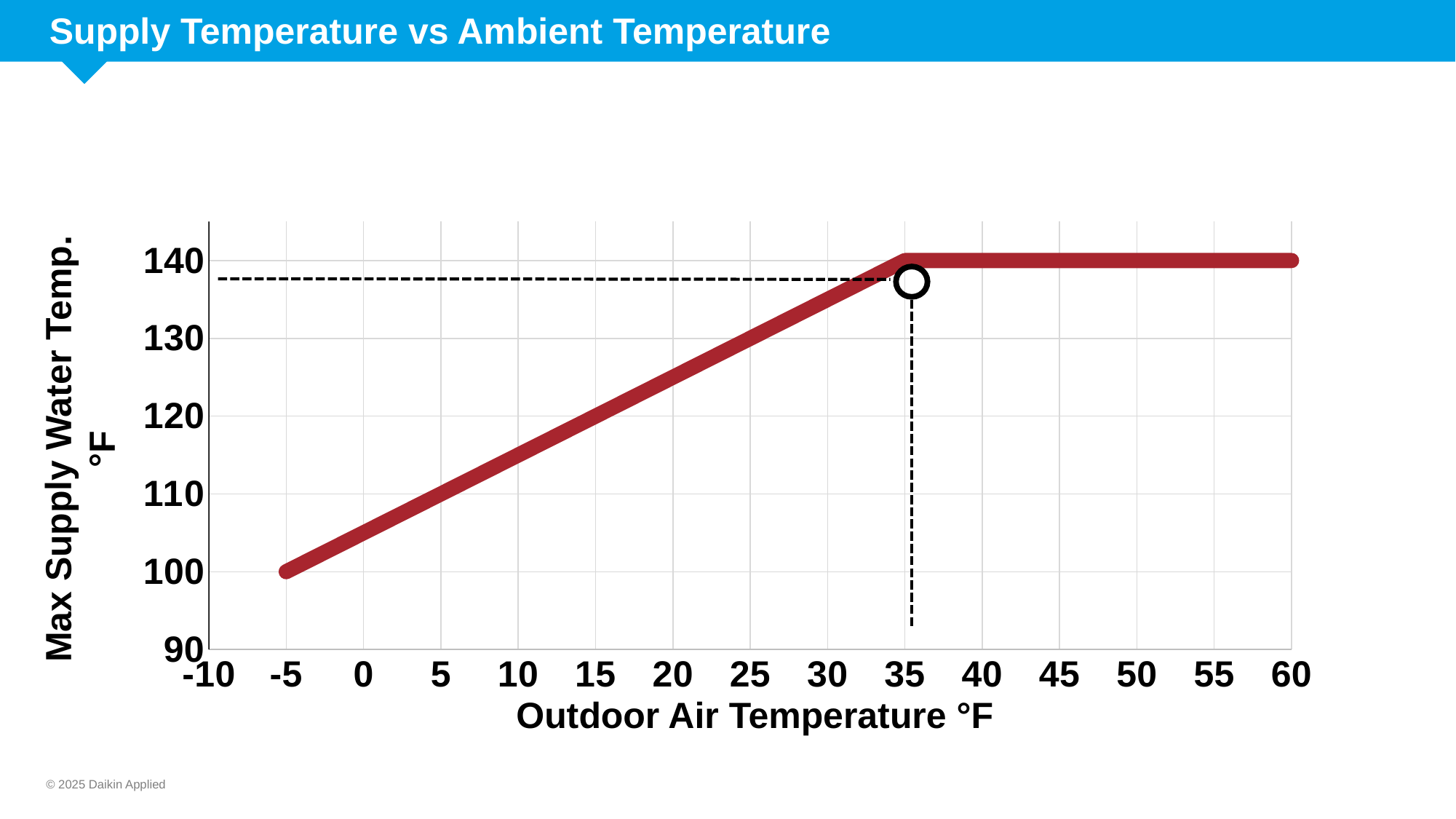
What is the Max Supply Water Temp. at an Outdoor Air Temperature of 60 °F? 140 What is the Max Supply Water Temp. at an Outdoor Air Temperature of -5 °F? 100 What kind of chart is shown on the slide? Line chart Is the Max Supply Water Temp. at an Outdoor Air Temperature of 15 °F greater or less than 110? greater What is the title of the x axis? Outdoor Air Temperature °F How does the Max Supply Water Temp. change as Outdoor Air Temperature rises from 35 °F to 60 °F? It stays flat Is the Max Supply Water Temp. at an Outdoor Air Temperature of 5 °F greater or less than 120? less What is the Max Supply Water Temp. at an Outdoor Air Temperature of 35 °F, where the circle marker is? 140 What is the difference between the Max Supply Water Temp. at 60 °F and at -5 °F Outdoor Air Temperature? 40 How does the Max Supply Water Temp. change as Outdoor Air Temperature rises from -5 °F to 35 °F? It rises Which has a higher Max Supply Water Temp.: an Outdoor Air Temperature of 10 °F or 50 °F? 50 °F Is the Max Supply Water Temp. at an Outdoor Air Temperature of 45 °F greater or less than 130? greater